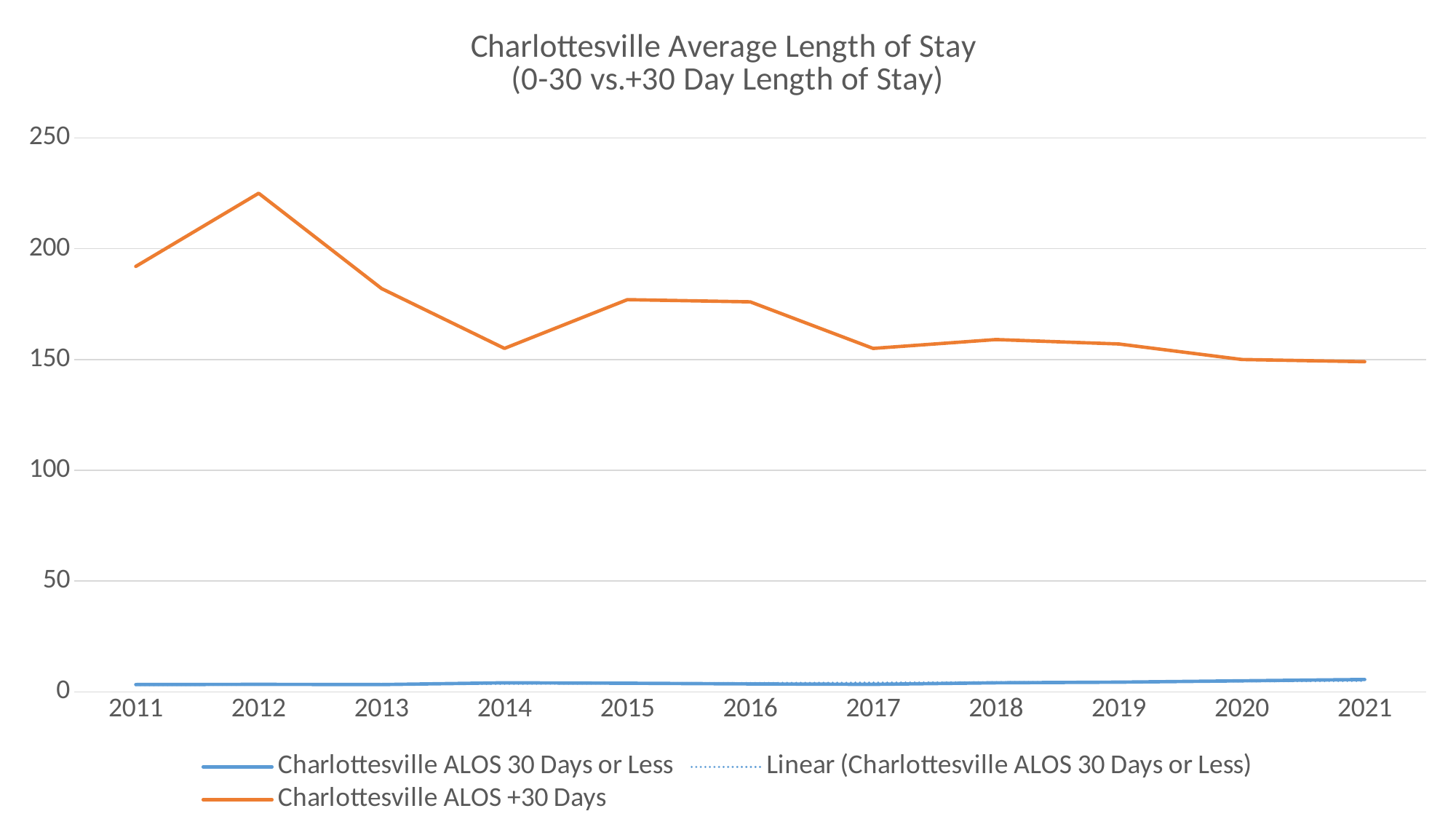
Is the Charlottesville ALOS 30 Days or Less value for 2021 greater or less than 50? less How many entries does the legend list? 3 Is the Charlottesville ALOS +30 Days value for 2011 greater or less than 200? less In which year does the Charlottesville ALOS +30 Days line reach its highest value? 2012 Is the Charlottesville ALOS +30 Days value for 2015 greater or less than 150? greater Overall, does the Charlottesville ALOS +30 Days line rise or fall from 2011 to 2021? fall What colour is the Charlottesville ALOS +30 Days line? orange What kind of chart is shown on the slide? line chart How many years are plotted along the x axis? 11 Which is larger for Charlottesville ALOS +30 Days: the value for 2012 or the value for 2013? 2012 Which is larger for Charlottesville ALOS +30 Days: the value for 2015 or the value for 2017? 2015